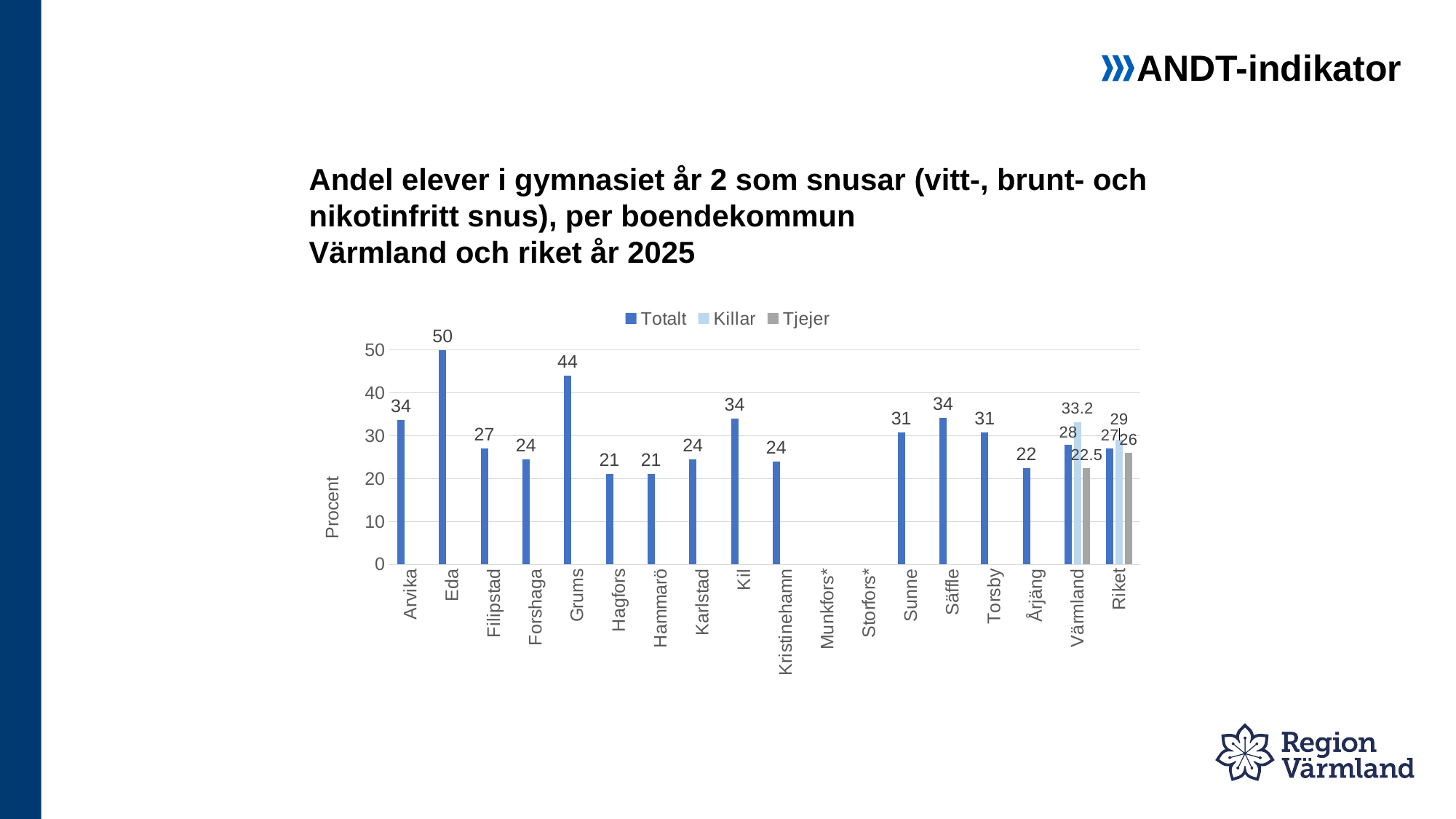
What is the Totalt value for Eda? 50 What is the Tjejer value for Riket? 26 What is the difference between the Killar and Tjejer values for Värmland? 10.7 Which category has the highest Totalt value? Eda What kind of chart is shown on the slide? bar chart What is the difference between the Totalt values for Eda and Grums? 6 What is the label on the y axis? Procent How many series does the legend list? 3 Which has a higher Totalt value, Kil or Sunne? Kil What is the Killar value for Värmland? 33.2 Is the Totalt value for Årjäng greater or less than 30? less How many categories are shown on the x axis? 18